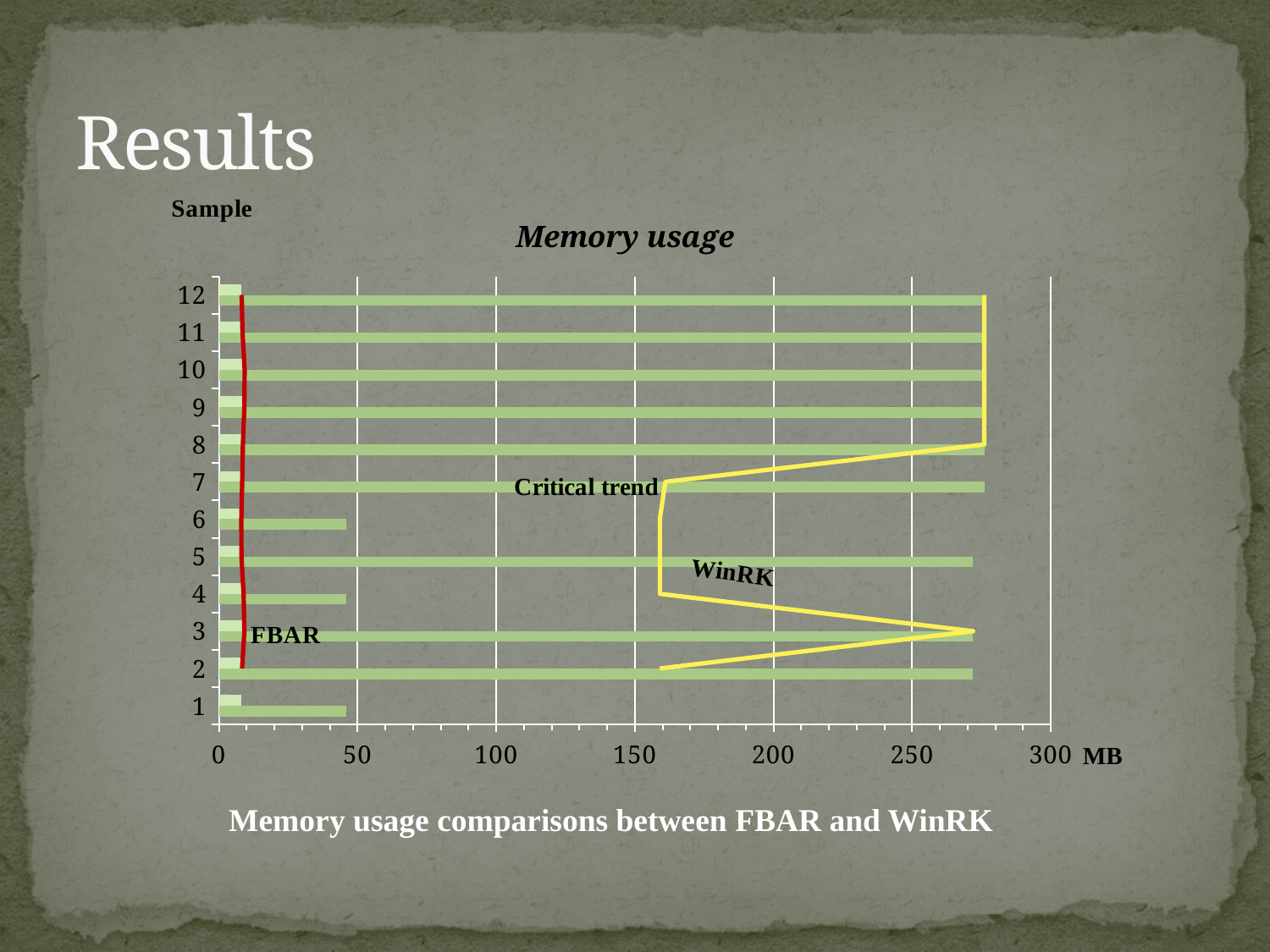
Is the WinRK memory usage for sample 1 greater or less than 100? less What is the title of the chart? Memory usage Is the WinRK memory usage for sample 12 greater or less than 250? greater For sample 5, which uses more memory, FBAR or WinRK? WinRK Is the WinRK memory usage for sample 2 greater or less than 250? greater Which has the larger WinRK memory usage, sample 3 or sample 4? sample 3 What kind of chart is shown on the slide? bar chart What unit is shown at the end of the horizontal axis? MB Which has the larger WinRK memory usage, sample 7 or sample 6? sample 7 How many samples are listed on the vertical axis of the chart? 12